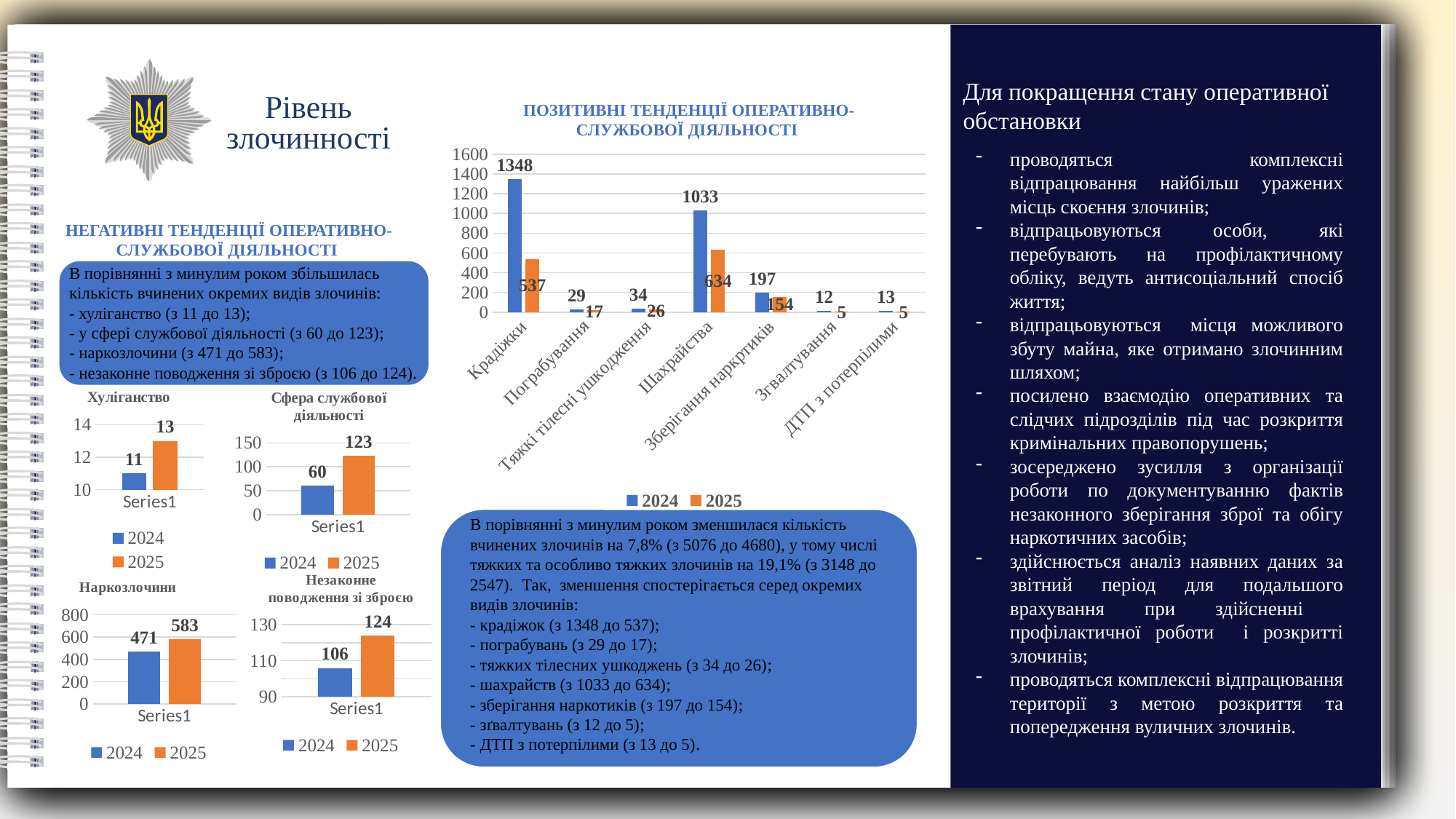
In the chart titled 'ПОЗИТИВНІ ТЕНДЕНЦІЇ ОПЕРАТИВНО-СЛУЖБОВОЇ ДІЯЛЬНОСТІ', how many series does the legend list? 2 In the chart titled 'ПОЗИТИВНІ ТЕНДЕНЦІЇ ОПЕРАТИВНО-СЛУЖБОВОЇ ДІЯЛЬНОСТІ', what is the difference between the 2024 and 2025 values for Зберігання наркотиків? 43 In the chart titled 'Хуліганство', what is the 2025 value? 13 What kind of chart is the chart titled 'Наркозлочини'? Bar chart In the chart titled 'Наркозлочини', which is larger, the 2024 value or the 2025 value? 2025 In the chart titled 'Незаконне поводження зі зброєю', what is the 2024 value? 106 In the chart titled 'ПОЗИТИВНІ ТЕНДЕНЦІЇ ОПЕРАТИВНО-СЛУЖБОВОЇ ДІЯЛЬНОСТІ', what is the 2024 value for Крадіжки? 1348 In the chart titled 'ПОЗИТИВНІ ТЕНДЕНЦІЇ ОПЕРАТИВНО-СЛУЖБОВОЇ ДІЯЛЬНОСТІ', which category has the highest 2024 value? Крадіжки In the chart titled 'ПОЗИТИВНІ ТЕНДЕНЦІЇ ОПЕРАТИВНО-СЛУЖБОВОЇ ДІЯЛЬНОСТІ', what is the 2025 value for Шахрайства? 634 In the chart titled 'Сфера службової діяльності', what is the difference between the 2025 and 2024 values? 63 In the chart titled 'ПОЗИТИВНІ ТЕНДЕНЦІЇ ОПЕРАТИВНО-СЛУЖБОВОЇ ДІЯЛЬНОСТІ', how many categories are shown on the x axis? 7 In the chart titled 'ПОЗИТИВНІ ТЕНДЕНЦІЇ ОПЕРАТИВНО-СЛУЖБОВОЇ ДІЯЛЬНОСТІ', what colour are the 2025 bars? Orange